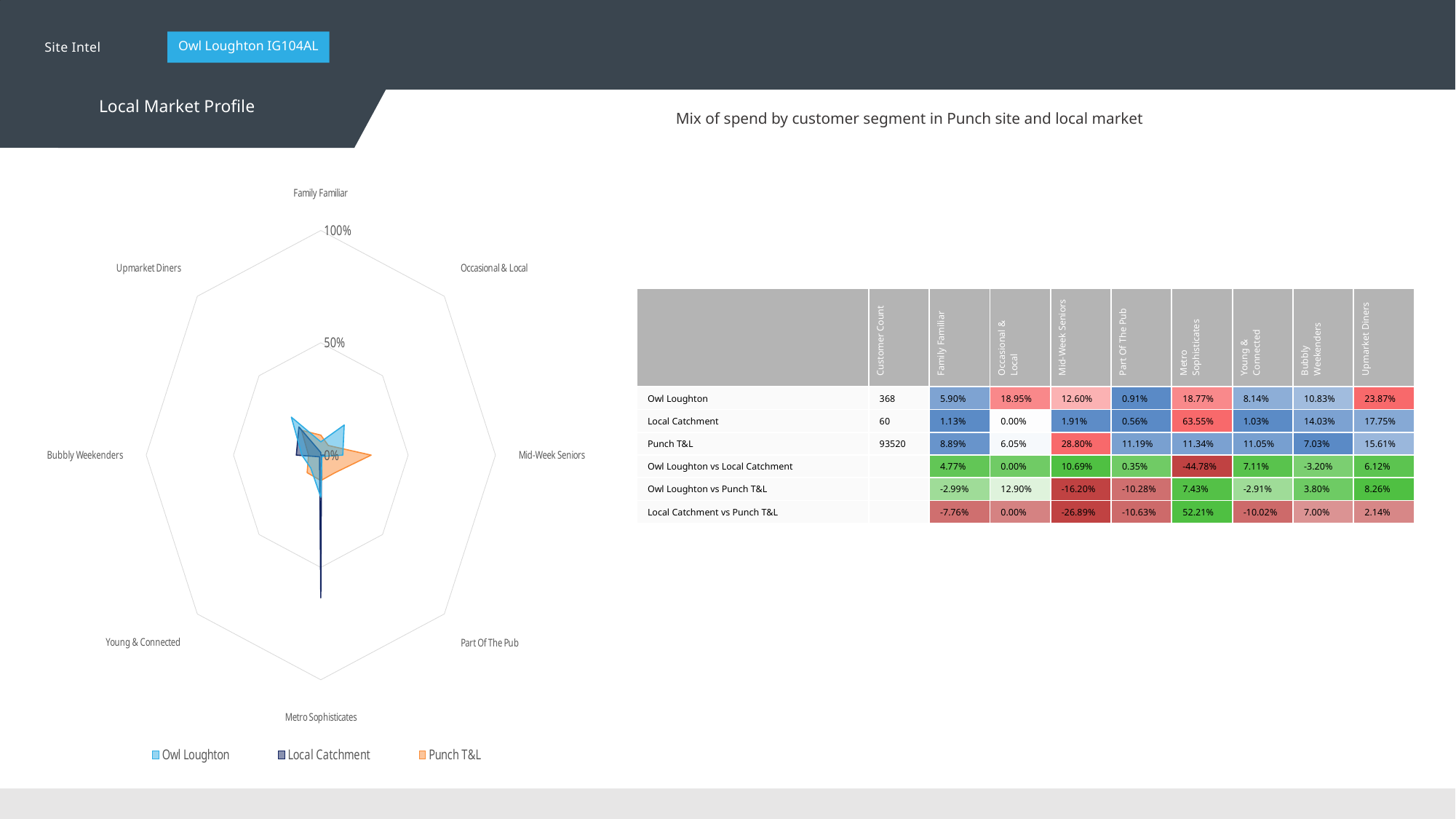
What kind of chart is shown on the left of the slide? Radar chart How many series does the radar chart's legend list? 3 For Metro Sophisticates, which series is larger: Local Catchment or Owl Loughton? Local Catchment What are the three series named in the radar chart's legend? Owl Loughton, Local Catchment, Punch T&L Is the Owl Loughton value for Upmarket Diners greater or less than 50%? less Which category has the highest value for the Local Catchment series? Metro Sophisticates How many customer segment categories does the radar chart have? 8 What is the Owl Loughton value for Upmarket Diners? 23.87% What is the Local Catchment value for Metro Sophisticates? 63.55% Is the Local Catchment value for Metro Sophisticates greater or less than 50%? greater What is the Punch T&L value for Mid-Week Seniors? 28.80% What is the highest percentage tick shown on the radar chart's axis? 100%